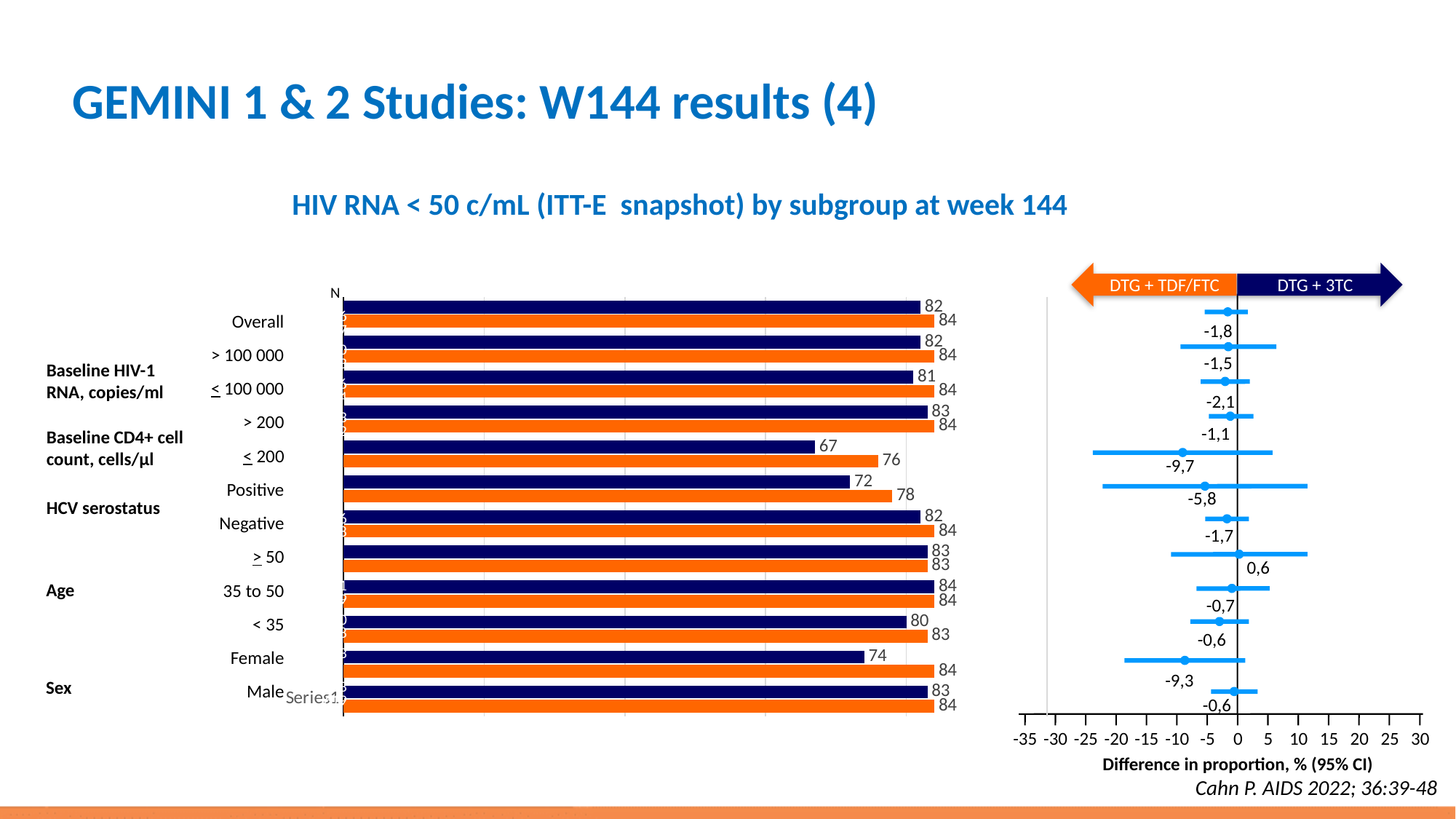
In the left bar chart, what is the value of the orange bar for the HCV serostatus Positive subgroup? 78 In the left bar chart, what is the value of the orange bar for the Female subgroup? 84 What is the x-axis label of the right forest plot? Difference in proportion, % (95% CI) In the right forest plot, which subgroup has the highest (only positive) difference in proportion? ≥ 50 (Age) In the right forest plot, what is the difference in proportion for the Female subgroup? -9,3 In the left bar chart, for the HCV serostatus Positive subgroup, which bar is larger, the dark blue or the orange? orange What kind of chart is the chart on the left of the slide? bar chart In the left bar chart, how many subgroup categories are plotted? 12 In the left bar chart, what is the value of the dark blue bar for the Baseline CD4+ cell count ≤ 200 subgroup? 67 In the left bar chart, which subgroup has the lowest dark blue bar value? ≤ 200 (Baseline CD4+ cell count) In the left bar chart, what is the difference between the orange bar and the dark blue bar for the Female subgroup? 10 In the right forest plot, what is the difference in proportion for the Baseline CD4+ cell count ≤ 200 subgroup? -9,7